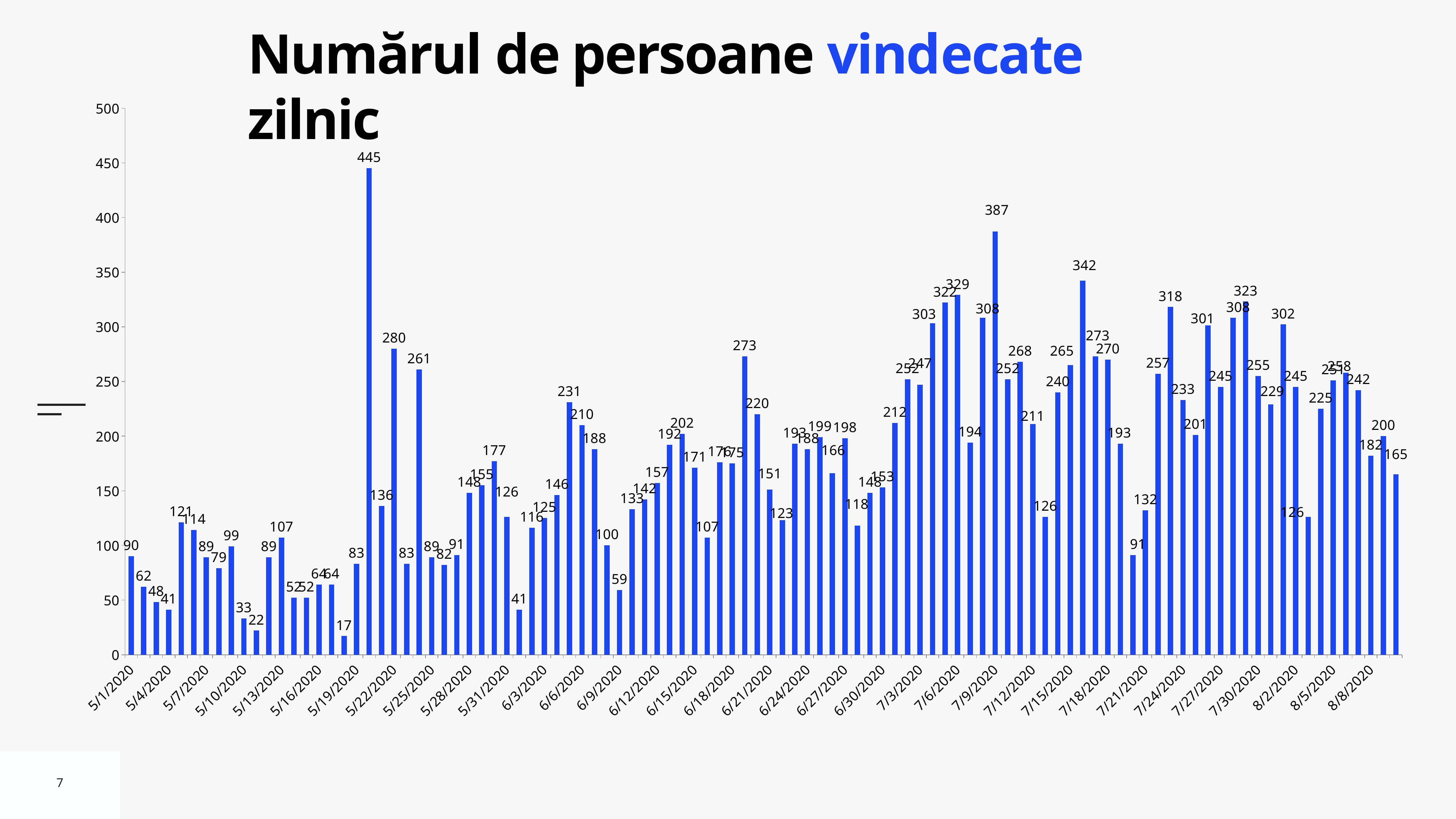
What is the value for 5/22/2020? 280 What type of chart is shown on the slide? bar chart What is the lowest value shown on the chart? 17 What is the value for 5/1/2020? 90 What is the value for 7/9/2020? 387 What is the value for 6/9/2020? 59 What is the highest value shown on the chart? 445 Is the value for 7/9/2020 greater or less than 350? greater Which is larger, the value for 5/22/2020 or the value for 5/25/2020? 5/22/2020 What is the difference between the values for 7/9/2020 and 7/6/2020? 58 What is the title of the chart? Numărul de persoane vindecate zilnic Do the values generally rise or fall from early May to early July? rise